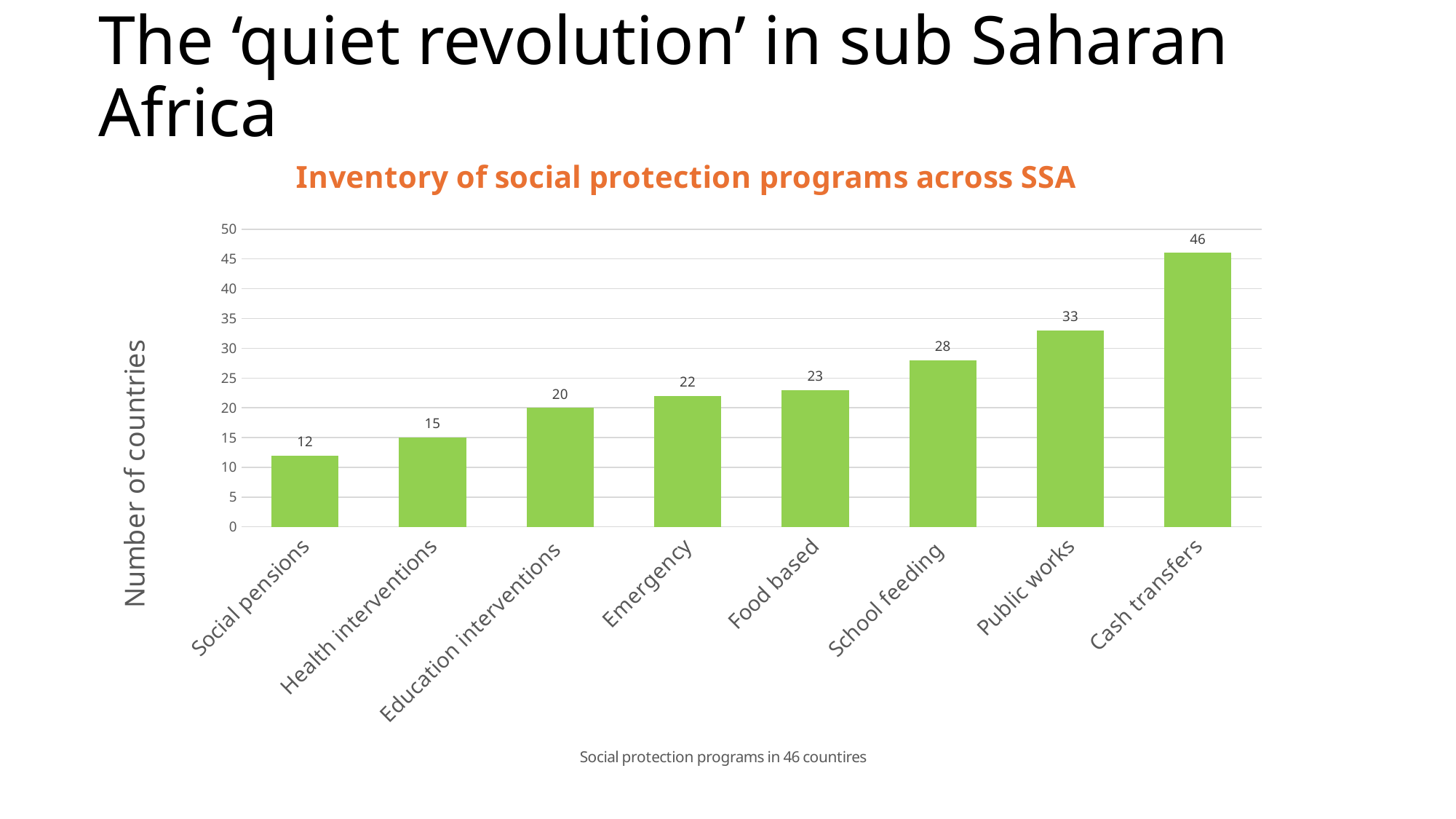
Is the value for School feeding greater or less than 25? greater How many countries have social pensions programs? 12 What is the difference between the values for Cash transfers and Public works? 13 What is the difference between the values for Food based and Emergency? 1 What is the value for School feeding? 28 How many program categories are shown on the chart? 8 What is the title of the chart? Inventory of social protection programs across SSA Which program type has the lowest number of countries? Social pensions Which has a larger value, Health interventions or Education interventions? Education interventions What is the value for Public works? 33 What kind of chart is shown on the slide? Bar chart Which program type has the highest number of countries? Cash transfers